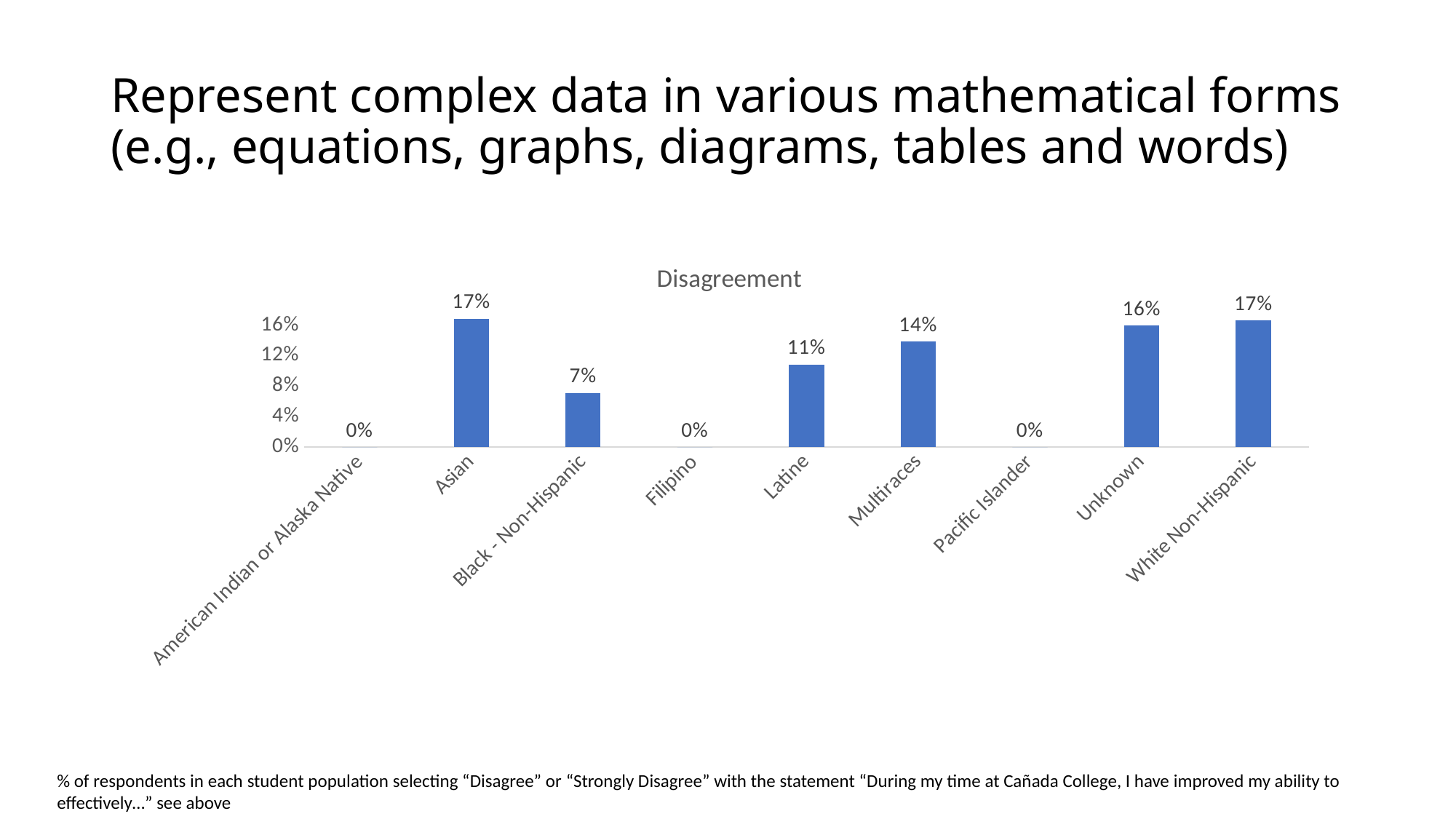
How many categories are shown on the x axis of the chart? 9 What is the value for Latine in the Disagreement chart? 11% What is the value for Asian in the Disagreement chart? 17% What is the value for Black - Non-Hispanic in the Disagreement chart? 7% What is the title of the chart? Disagreement What is the value for Multiraces in the Disagreement chart? 14% What is the value for Unknown in the Disagreement chart? 16% What is the difference between the values for Multiraces and Latine? 3% What is the difference between the values for Asian and Black - Non-Hispanic? 10% What is the value for Filipino in the Disagreement chart? 0% What kind of chart is shown on the slide? Bar chart Which is larger, the value for Unknown or the value for Multiraces? Unknown